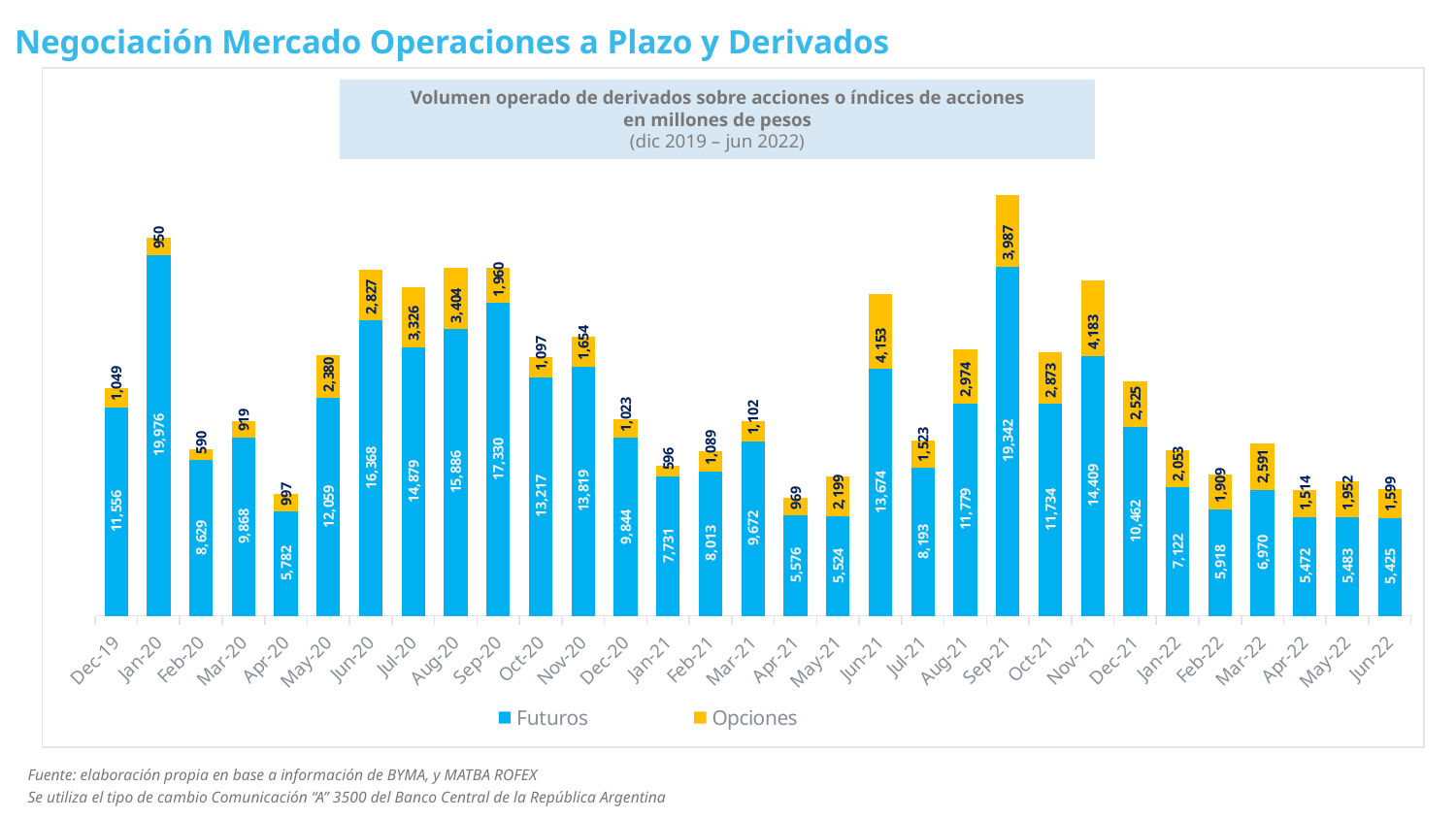
What is the difference between the Futuros values for Jan-20 and Feb-20? 11,347 Which is larger, the Opciones value for Jun-21 or the Opciones value for Jul-21? Jun-21 What is the Futuros value for Jan-20? 19,976 What is the total of the stacked bar for Sep-21? 23,329 How many months are plotted on the x axis? 31 What is the Opciones value for Sep-21? 3,987 How many series does the legend list? 2 What type of chart is shown on the slide? Stacked bar chart What is the Futuros value for Jun-22? 5,425 What are the two series named in the legend? Futuros and Opciones Do the Futuros values rise or fall from Sep-21 to Jun-22? Fall Which month has the highest Futuros value? Jan-20